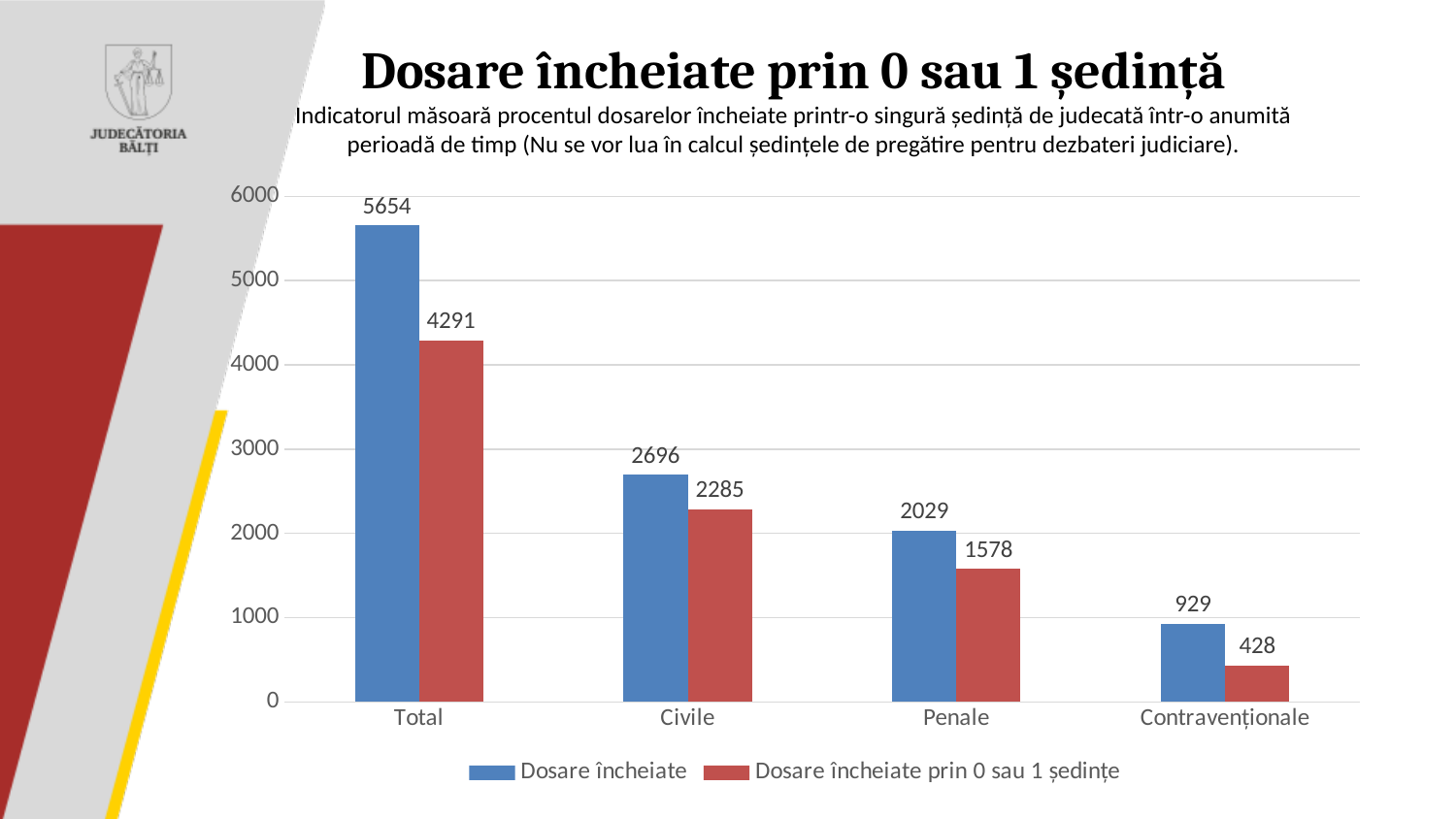
What is the value of "Dosare încheiate prin 0 sau 1 ședințe" for Penale? 1578 What is the value of "Dosare încheiate prin 0 sau 1 ședințe" for Contravenționale? 428 What is the difference between "Dosare încheiate" and "Dosare încheiate prin 0 sau 1 ședințe" for Total? 1363 How many categories are shown on the x axis? 4 What is the value of "Dosare încheiate" for Civile? 2696 What is the difference between "Dosare încheiate" for Civile and "Dosare încheiate" for Penale? 667 Which is larger: "Dosare încheiate prin 0 sau 1 ședințe" for Civile or "Dosare încheiate" for Penale? Dosare încheiate prin 0 sau 1 ședințe for Civile What kind of chart is shown on the slide? bar chart How many series does the legend list? 2 Is the value of "Dosare încheiate" for Contravenționale greater or less than 1000? less Which category has the lowest value for "Dosare încheiate"? Contravenționale Which category has the highest value for "Dosare încheiate prin 0 sau 1 ședințe"? Total